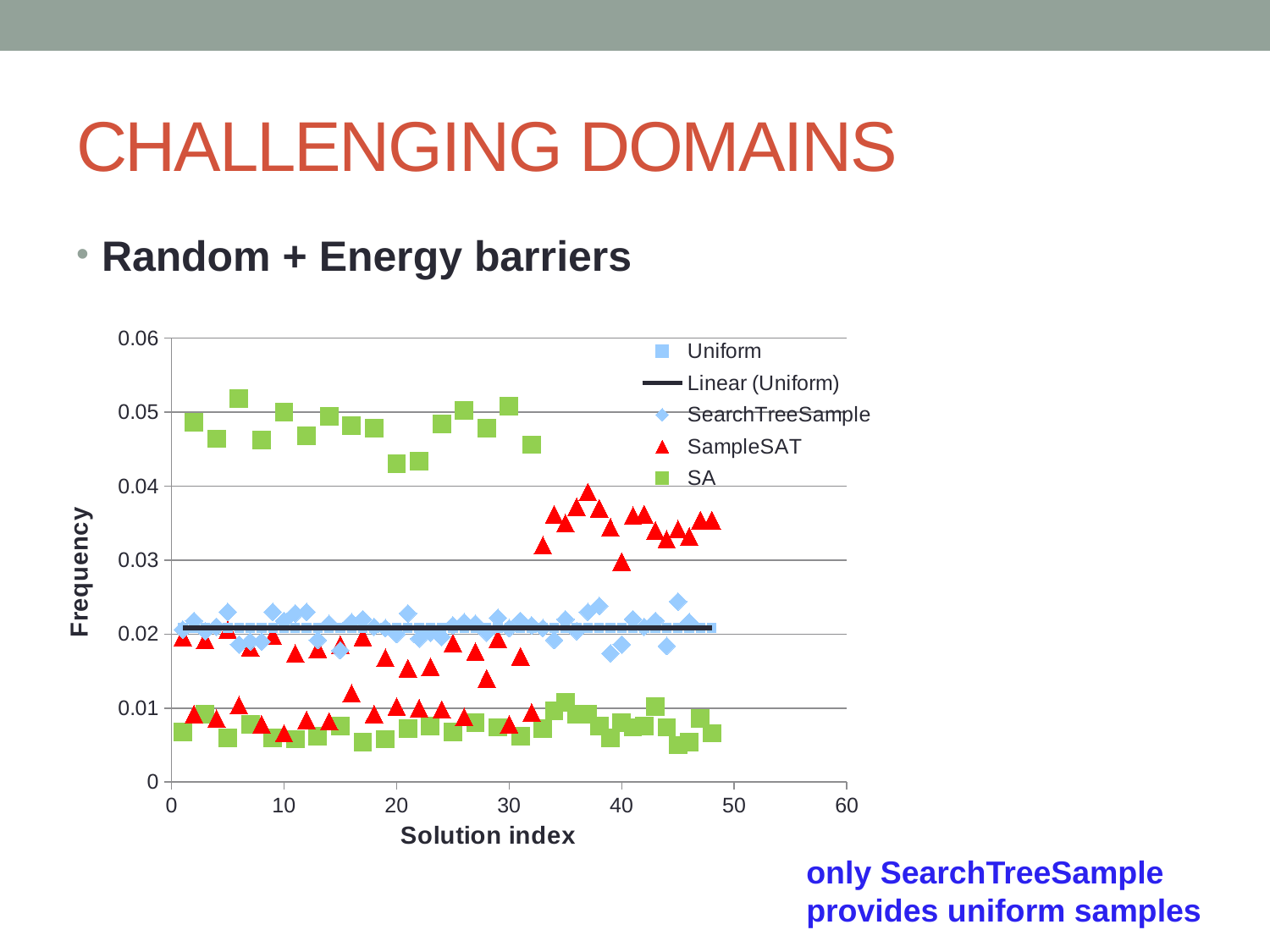
Is the SA value at solution index 45 greater or less than 0.01? less Is the Uniform value at solution index 30 greater or less than 0.01? greater Is the SA value at solution index 20 greater or less than 0.05? less Which series is plotted with red triangles? SampleSAT What kind of chart is shown on the slide? scatter chart What is the title of the x axis? Solution index How many series does the legend list? 5 Which series reaches the highest frequency on the chart? SA